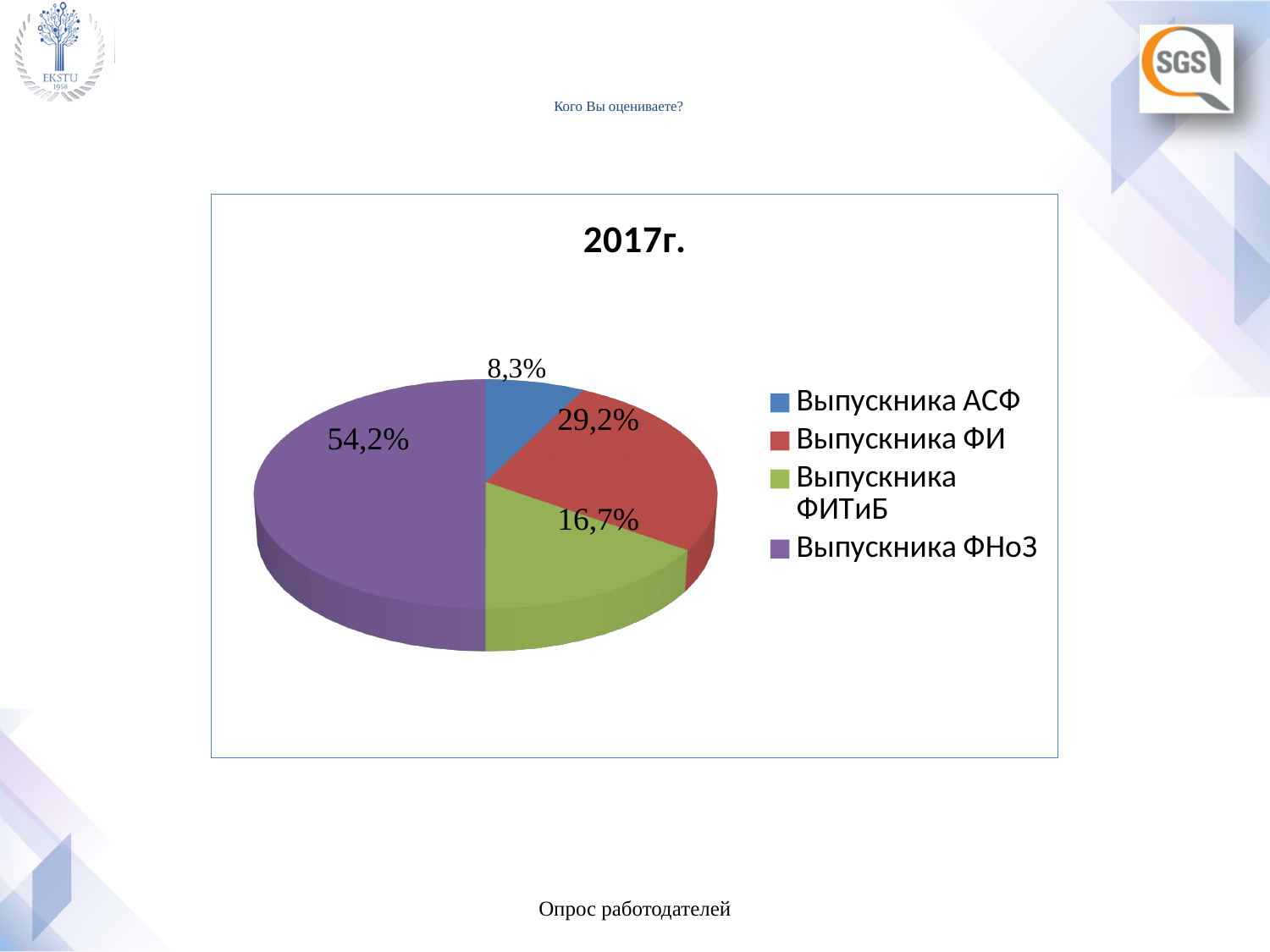
Which is larger, the value for Выпускника ФИ or Выпускника ФИТиБ? Выпускника ФИ How many categories does the pie chart show? 4 What is the title of the chart? 2017г. What type of chart is shown on the slide? Pie chart What is the value for Выпускника АСФ? 8,3% What colour is the slice for Выпускника ФИТиБ? Green Which category has the smallest slice of the pie? Выпускника АСФ Which category has the largest slice of the pie? Выпускника ФНоЗ What is the value for Выпускника ФИТиБ? 16,7% What is the value for Выпускника ФИ? 29,2% What is the difference between the values for Выпускника ФНоЗ and Выпускника ФИ? 25,0% What share of the pie does Выпускника ФНоЗ have? 54,2%